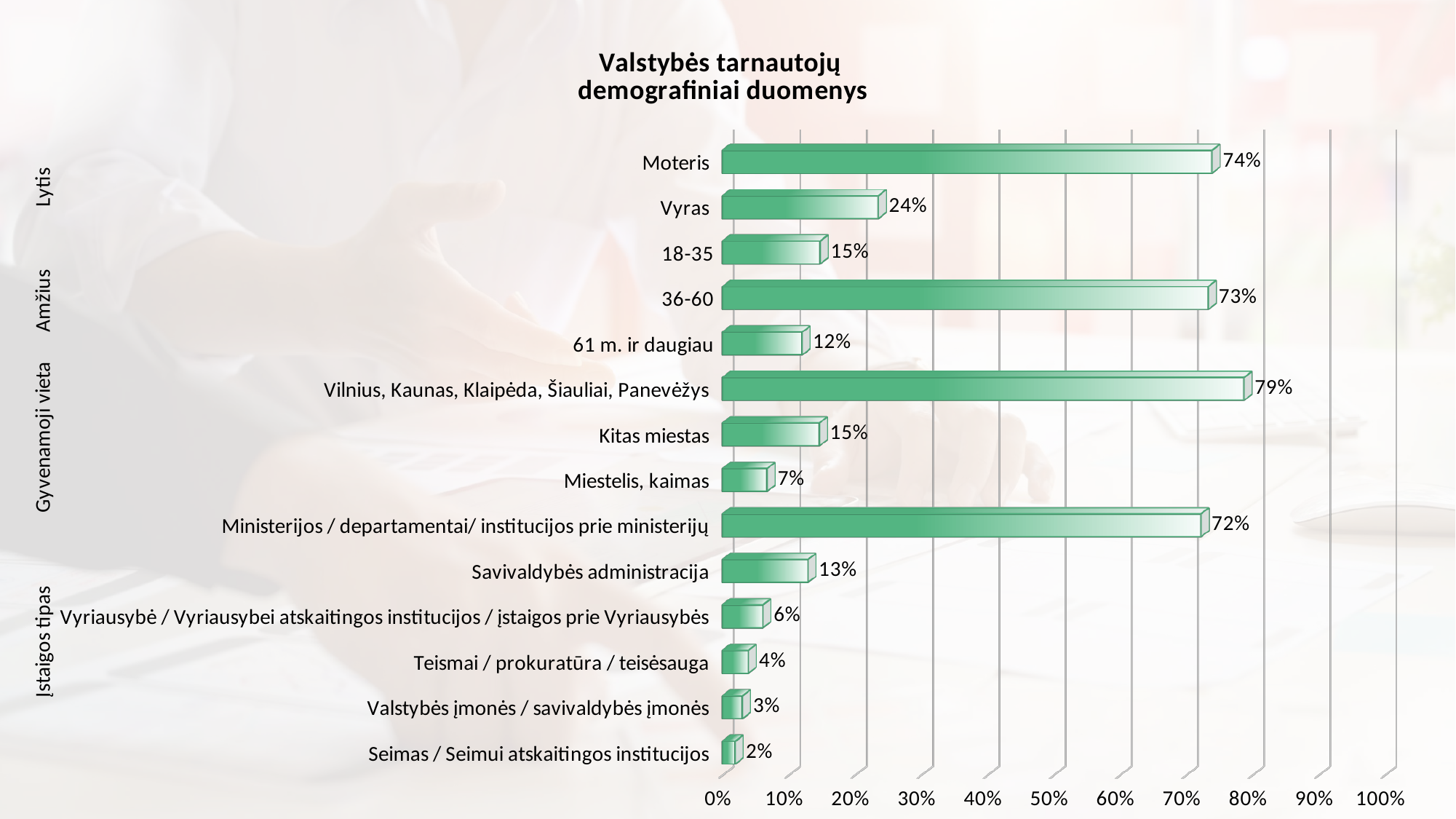
Which is larger, the value for 36-60 or the value for Ministerijos / departamentai/ institucijos prie ministerijų? 36-60 What is the title of the chart? Valstybės tarnautojų demografiniai duomenys How many categories are plotted in the chart? 14 What is the value for Vilnius, Kaunas, Klaipėda, Šiauliai, Panevėžys? 79% Which category has the highest value? Vilnius, Kaunas, Klaipėda, Šiauliai, Panevėžys What is the value for Moteris? 74% Is the value for Kitas miestas greater or less than 20%? less What is the difference between the values for Moteris and Vyras? 50% What is the value for Savivaldybės administracija? 13% Which category has the lowest value? Seimas / Seimui atskaitingos institucijos What kind of chart is shown on the slide? bar chart What is the value for 61 m. ir daugiau? 12%